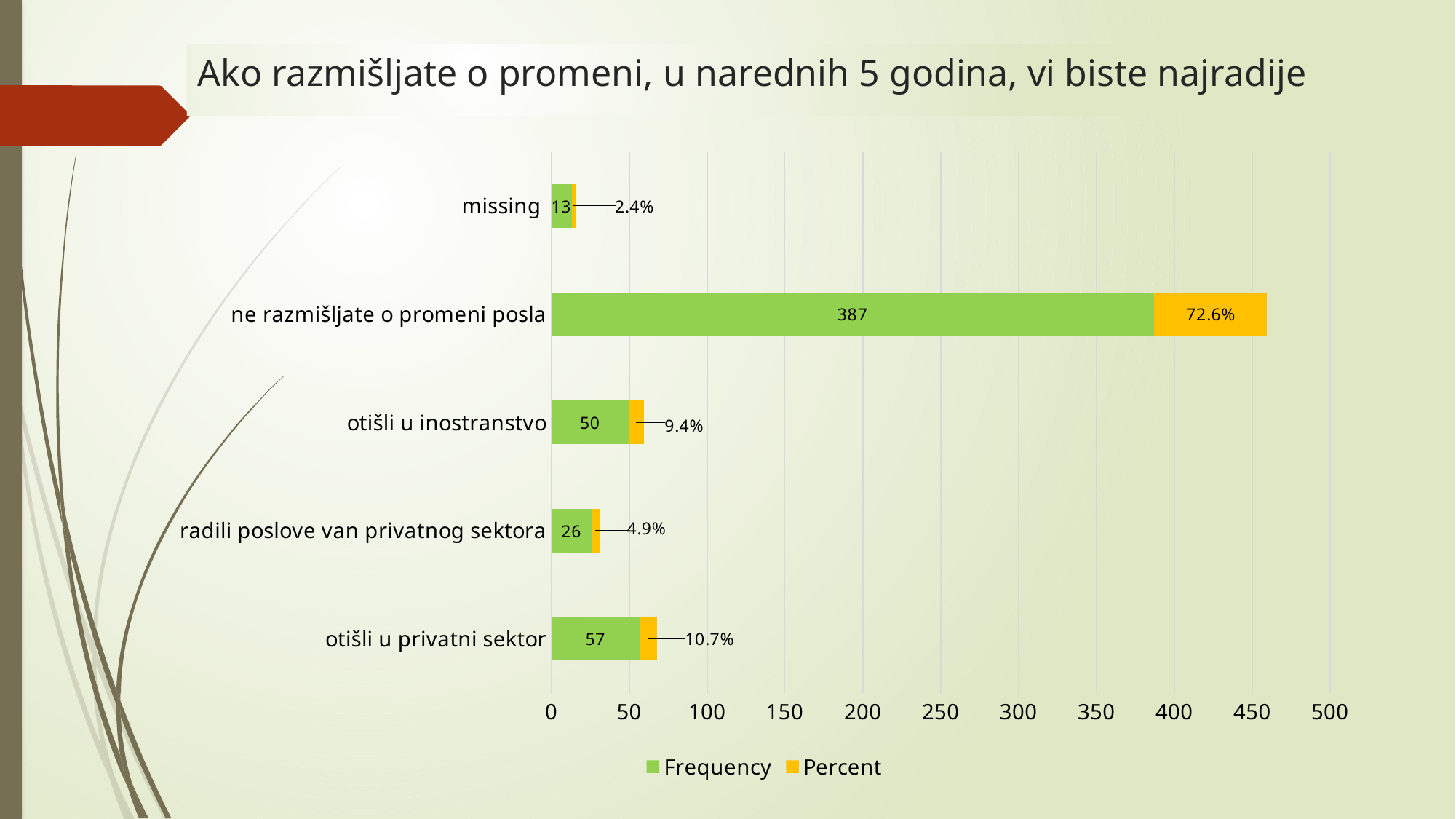
What is the Percent value for "otišli u inostranstvo"? 9.4% Which category has the highest Frequency? ne razmišljate o promeni posla How many series does the legend list? 2 Which has a larger Frequency, "radili poslove van privatnog sektora" or "otišli u inostranstvo"? otišli u inostranstvo What kind of chart is shown on the slide? bar chart What is the Frequency value for "radili poslove van privatnog sektora"? 26 Is the Frequency for "ne razmišljate o promeni posla" greater or less than 350? greater How many categories are shown on the chart? 5 Which category has the lowest Frequency? missing What is the Frequency value for "otišli u privatni sektor"? 57 What is the difference in Frequency between "otišli u privatni sektor" and "otišli u inostranstvo"? 7 What is the Percent value for "ne razmišljate o promeni posla"? 72.6%